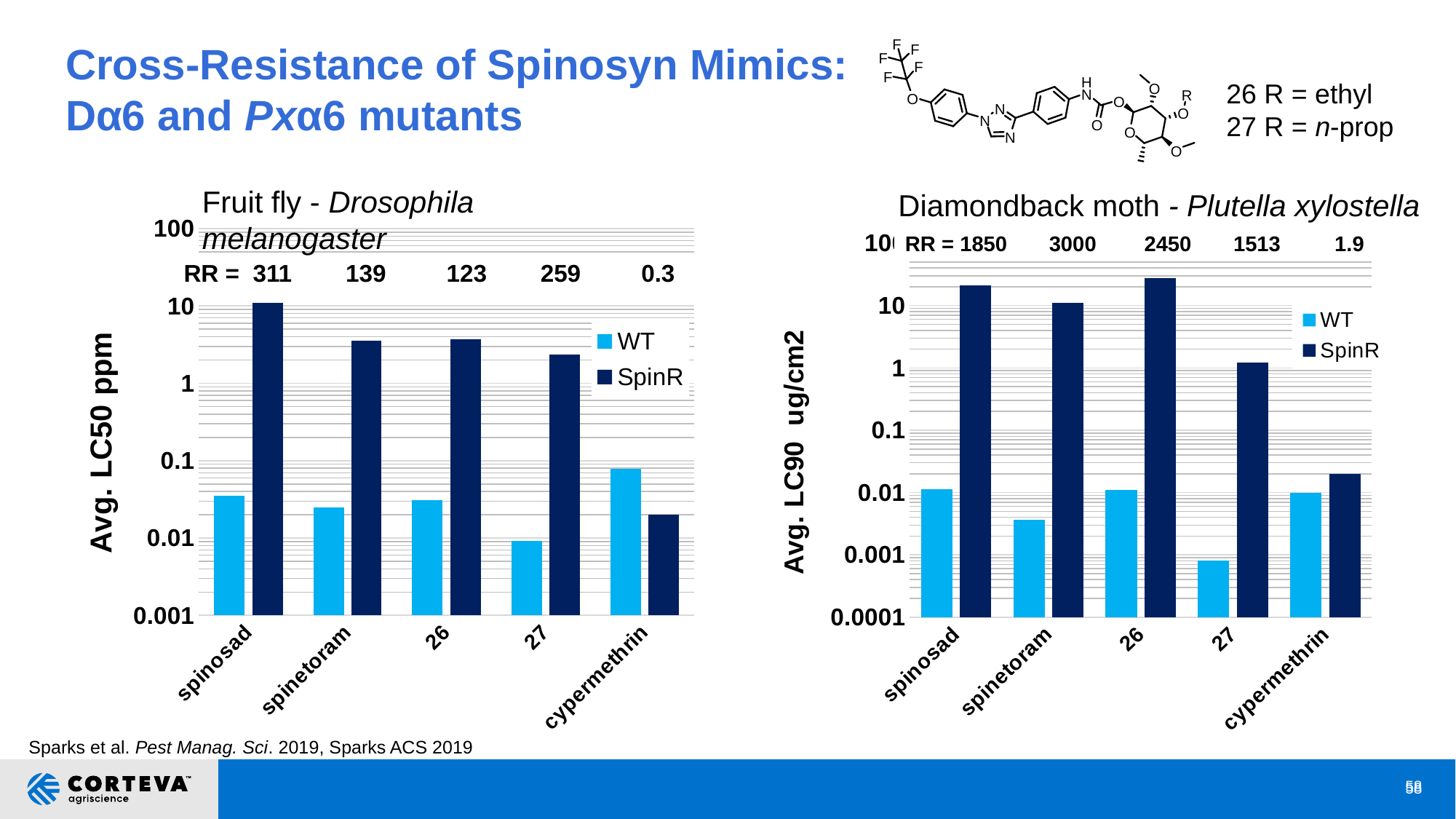
On the Fruit fly chart, for cypermethrin, which is larger: the WT value or the SpinR value? WT How many series does the legend of the Fruit fly chart list? 2 On the Diamondback moth chart, which category has the highest printed RR value? spinetoram On the Fruit fly chart, which category has the lowest printed RR value? cypermethrin What is the y-axis label of the Diamondback moth chart? Avg. LC90 ug/cm2 On the Fruit fly chart, what is the RR value printed for cypermethrin? 0.3 How many categories are shown on the x axis of the Diamondback moth chart? 5 On the Diamondback moth chart, what is the RR value printed for spinetoram? 3000 On the Fruit fly chart, which category has the lowest WT value? 27 On the Fruit fly chart, what is the RR value printed for spinosad? 311